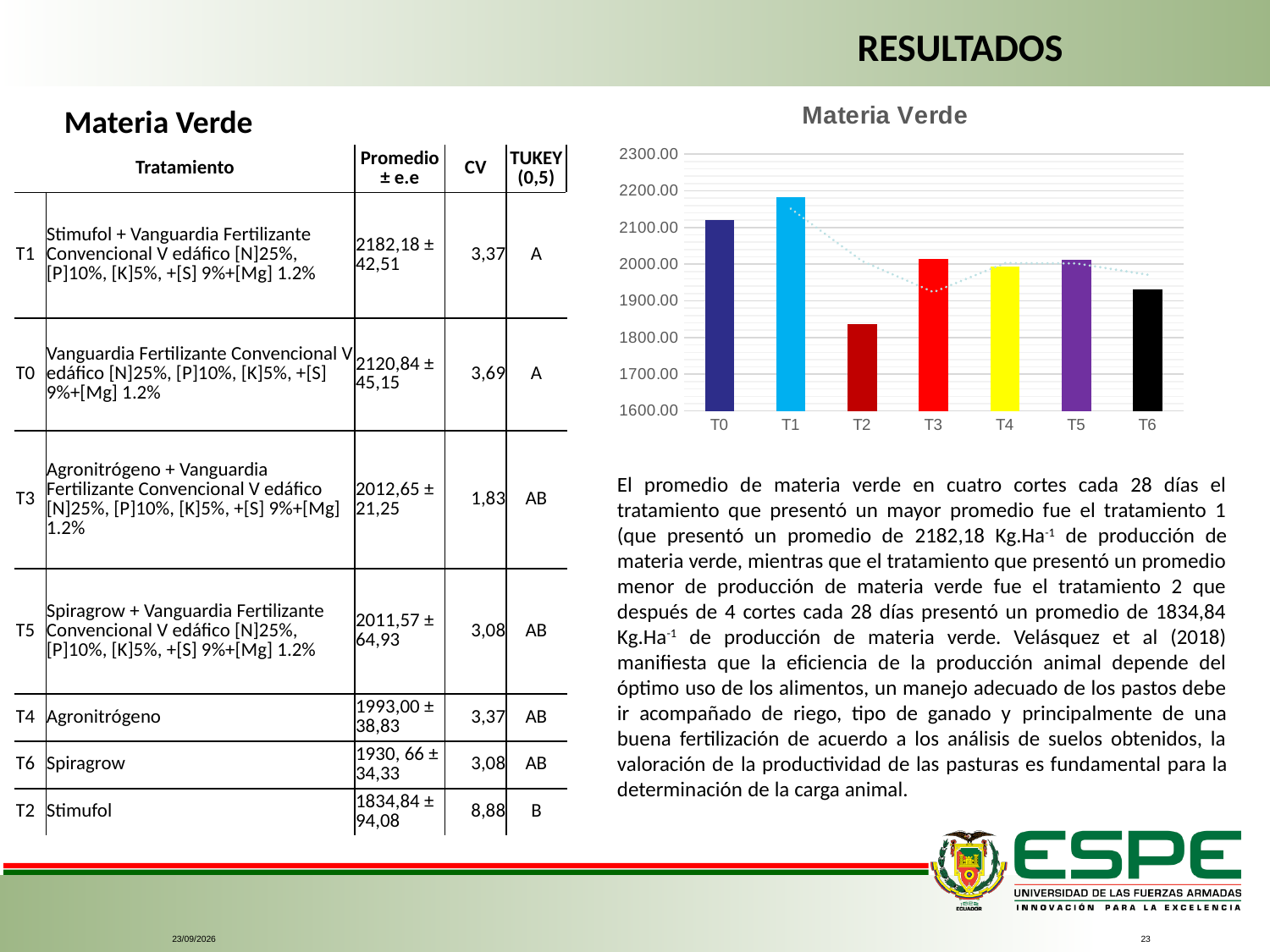
Is the value for T1 greater or less than 2100? greater What kind of chart is shown on the slide? bar chart Is the value for T6 greater or less than 2000? less Which is larger, the value for T4 or the value for T6? T4 Which is larger, the value for T0 or the value for T3? T0 How many treatments (categories) are plotted on the x axis of the chart? 7 Is the value for T3 greater or less than 2100? less Which treatment has the highest bar in the chart? T1 Which treatment has the lowest bar in the chart? T2 What colour is the bar for T4 in the chart? yellow What is the title of the chart? Materia Verde